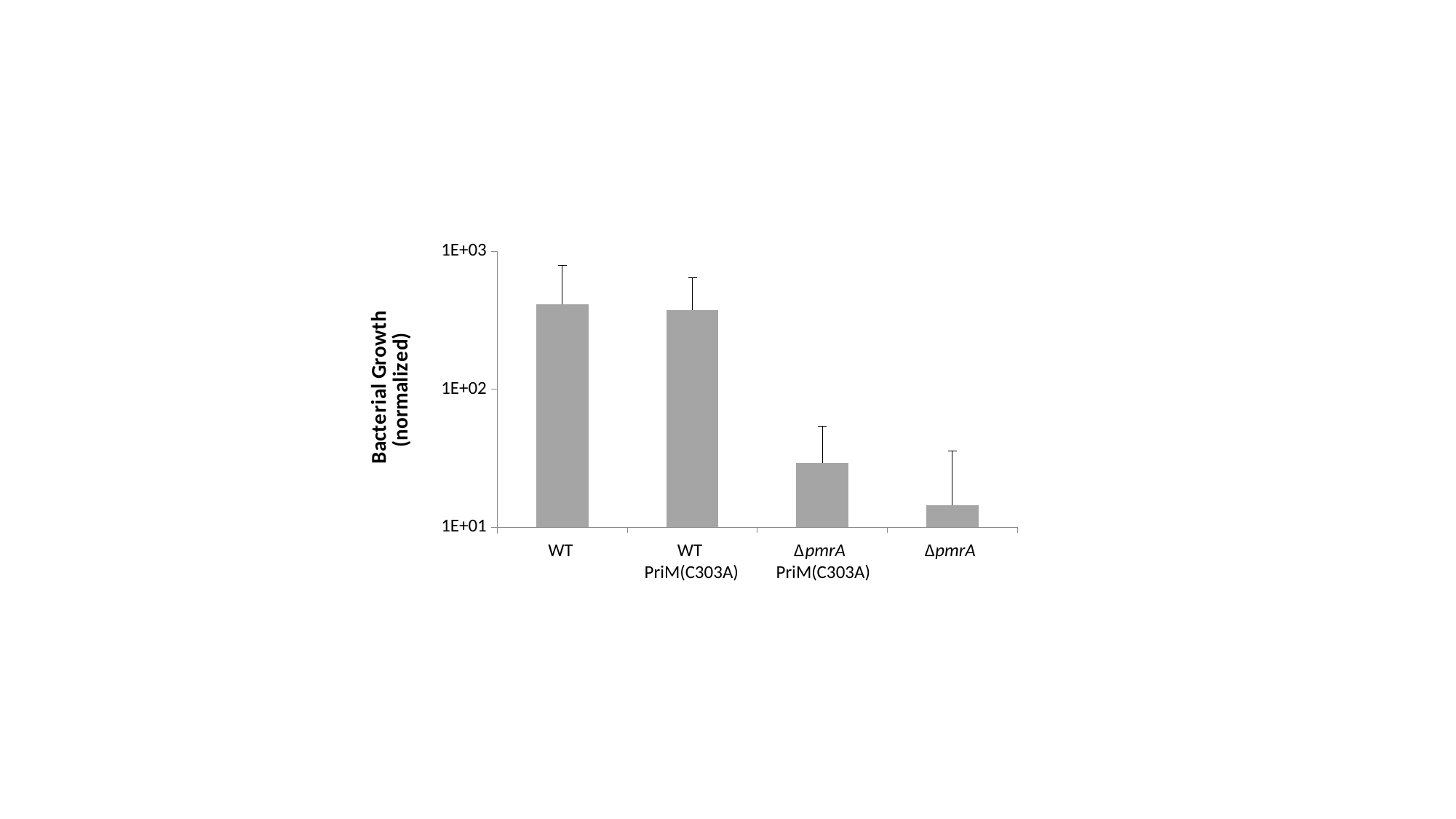
Is the value for ΔpmrA PriM(C303A) greater or less than 1E+02? less Do the bar values rise or fall from left to right along the x axis? fall Is the value for ΔpmrA greater or less than 1E+02? less What is the label of the y axis? Bacterial Growth (normalized) Which is larger, the value for WT PriM(C303A) or the value for ΔpmrA PriM(C303A)? WT PriM(C303A) Which category has the lowest bacterial growth? ΔpmrA What is the highest tick value shown on the y axis? 1E+03 Which is larger, the value for WT or the value for ΔpmrA? WT How many categories are plotted on the x axis? 4 What kind of chart is shown on the slide? bar chart Is the value for WT greater or less than 1E+02? greater